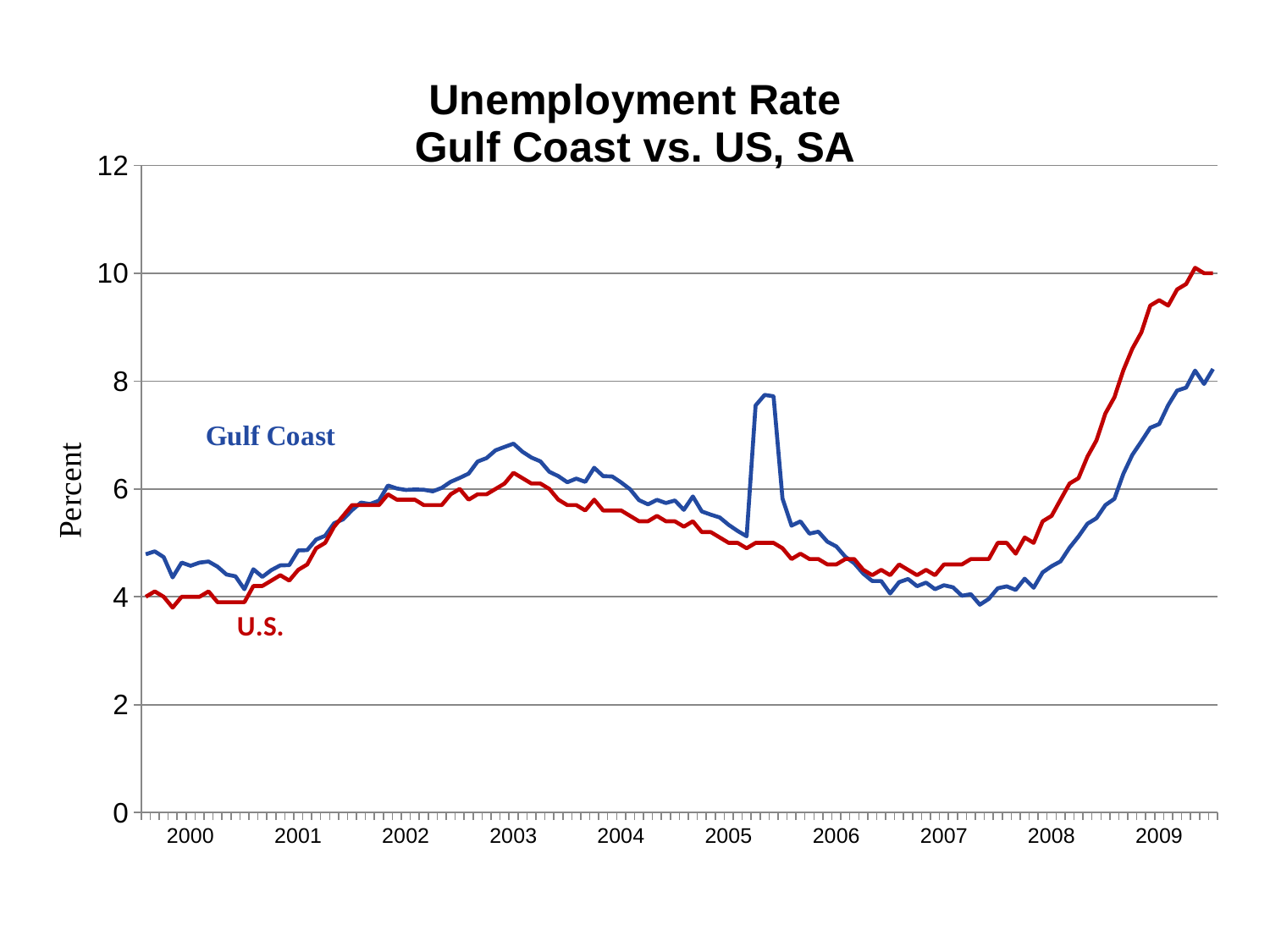
What is the title of the chart? Unemployment Rate Gulf Coast vs. US, SA At the end of 2009, which series is higher, Gulf Coast or U.S.? U.S. Is the U.S. value at the end of 2009 greater or less than 8? greater Is the Gulf Coast value at its 2005 spike greater or less than 6? greater Do the unemployment rates rise or fall from 2008 to 2009? rise How many series are plotted on the chart? 2 What is the label on the vertical axis? Percent During the 2005 spike, which series is higher, Gulf Coast or U.S.? Gulf Coast Which series reaches the highest value on the chart, Gulf Coast or U.S.? U.S. What kind of chart is shown on the slide? line chart Is the U.S. value in mid-2007 greater or less than 6? less In which year does the U.S. unemployment rate reach its highest point on the chart? 2009